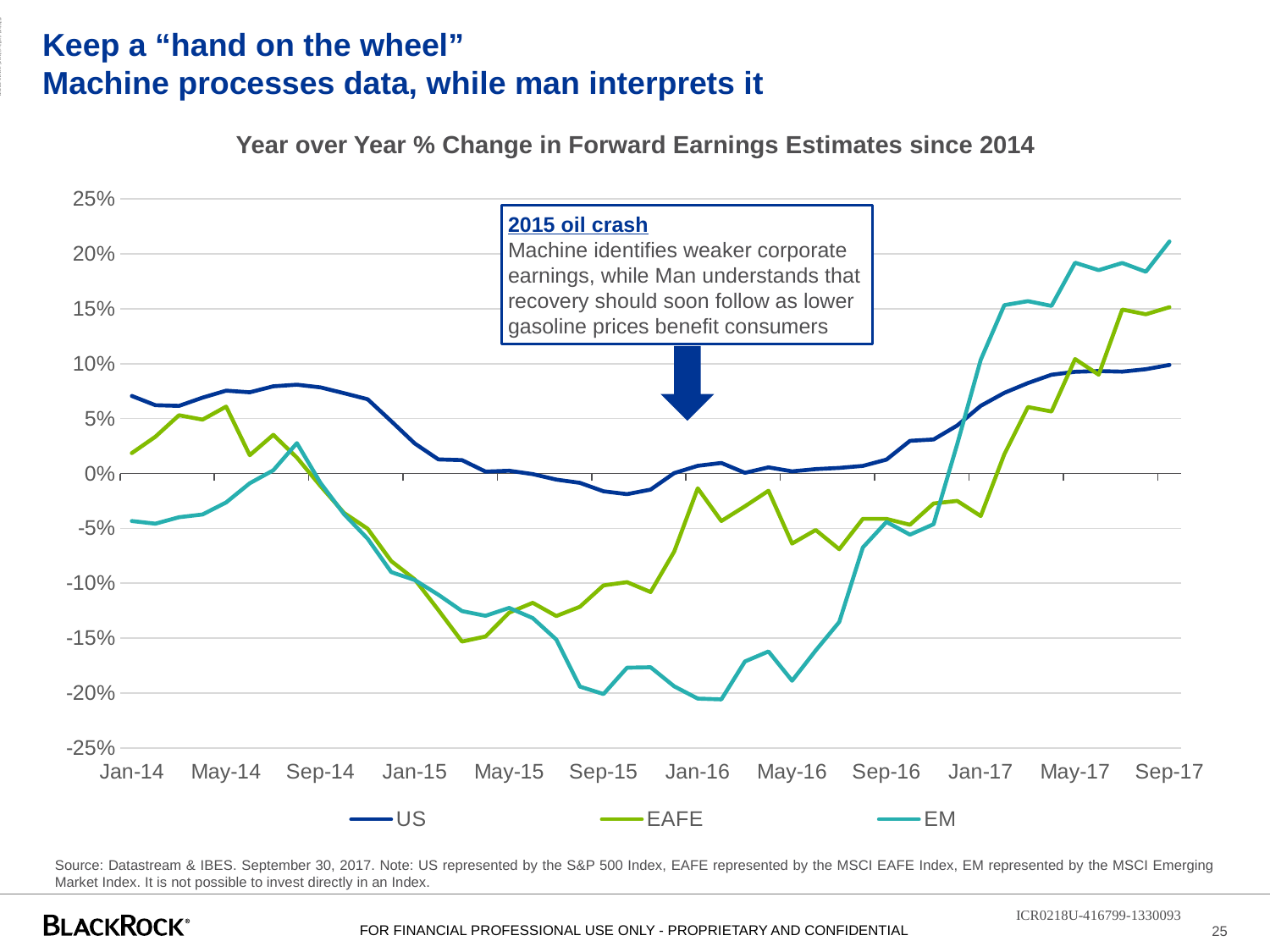
At Sep-17, which series has the higher value, EM or EAFE? EM Does the EM series rise or fall between Sep-16 and Sep-17? Rise Is the value for EAFE at May-15 greater or less than -10%? less Is the value for US at Sep-14 greater or less than 5%? greater What kind of chart is shown on the slide? Line chart Is the value for EM at Sep-17 greater or less than 15%? greater How many series does the chart's legend list? 3 What is the title of the chart? Year over Year % Change in Forward Earnings Estimates since 2014 Which series has the highest value at Jan-14? US Which series are listed in the chart's legend? US, EAFE, EM Which series has the lowest value at Jan-16? EM